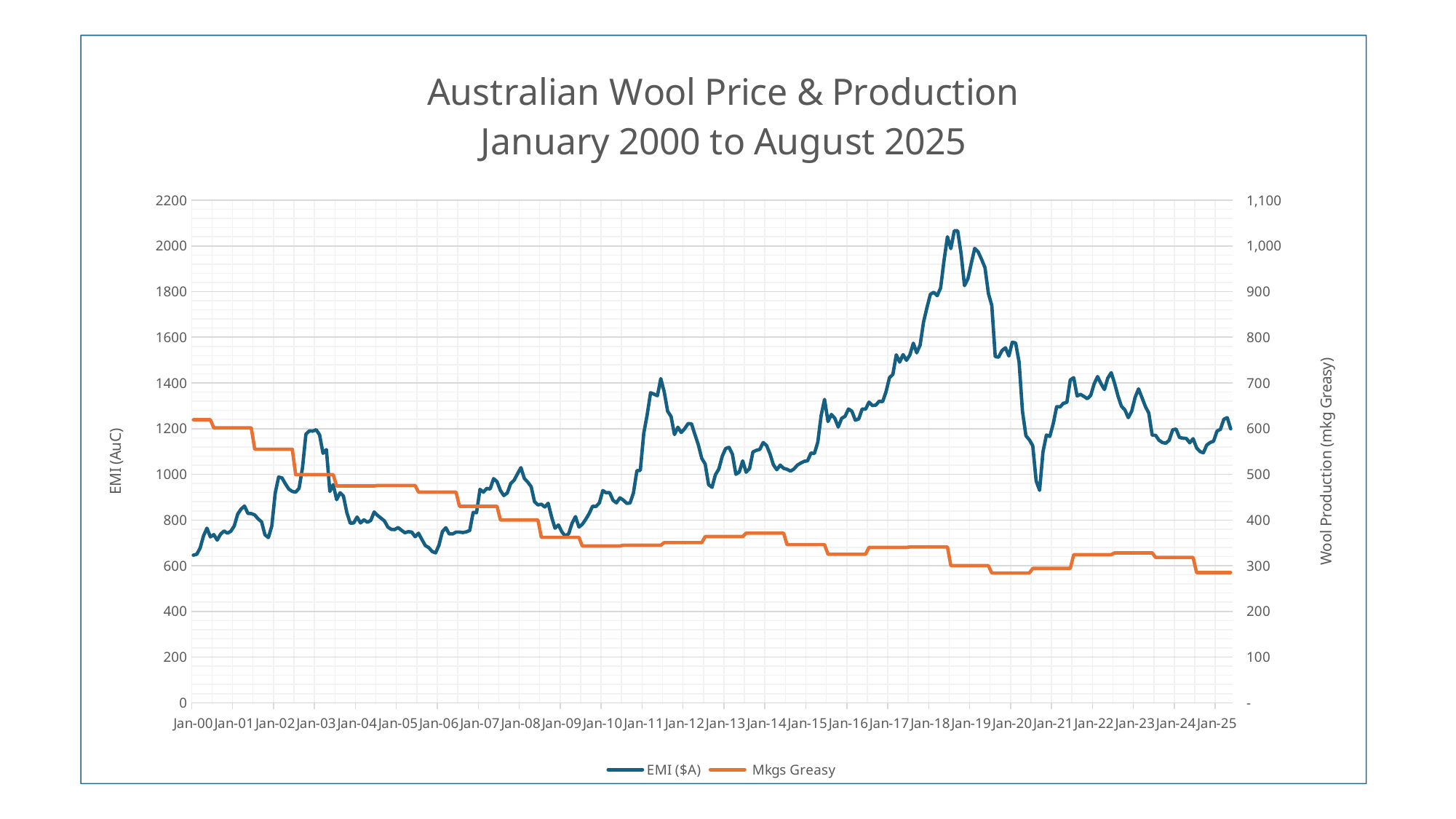
What is the title of the chart? Australian Wool Price & Production January 2000 to August 2025 What is the label of the right-hand vertical axis? Wool Production (mkg Greasy) Is the highest EMI ($A) value on the chart greater or less than 1800? greater Does the Mkgs Greasy series overall rise or fall from Jan-00 to Jan-25? Fall How many series does the legend list? 2 How many year labels are shown along the x axis? 26 Is the Mkgs Greasy value at Jan-00 greater or less than 500 on the right axis? greater Is the Mkgs Greasy value at Jan-25 greater or less than 400 on the right axis? less Does the EMI ($A) series overall rise or fall from Jan-00 to Jan-25? Rise What kind of chart is shown on the slide? Line chart Between which two x-axis labels does the EMI ($A) series reach its peak? Jan-18 and Jan-19